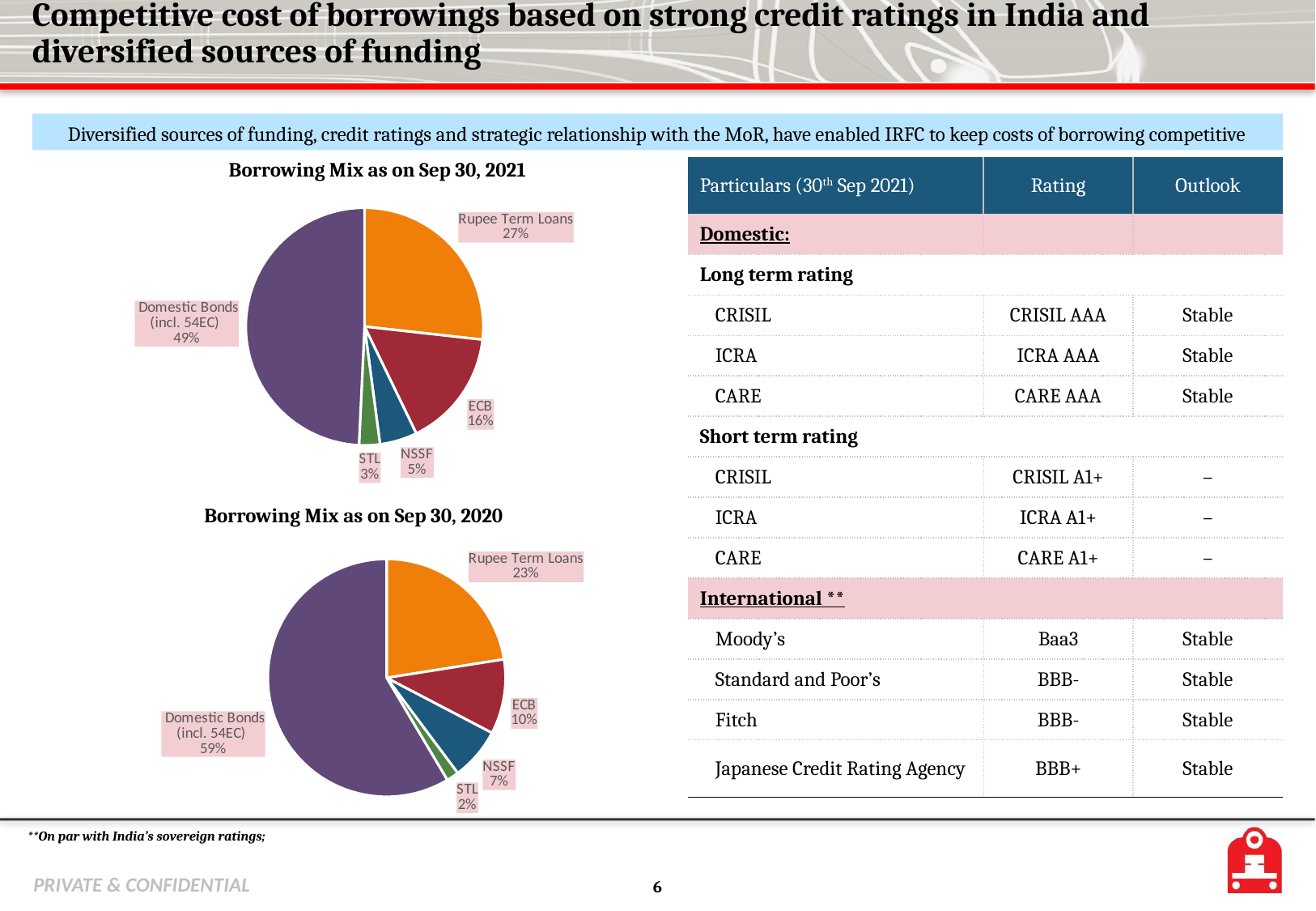
How many categories are shown in the 'Borrowing Mix as on Sep 30, 2021' chart? 5 In the 'Borrowing Mix as on Sep 30, 2020' chart, which category has the smallest share? STL In the 'Borrowing Mix as on Sep 30, 2020' chart, what is the share of Rupee Term Loans? 23% In the 'Borrowing Mix as on Sep 30, 2021' chart, what is the share of ECB? 16% What is the difference between the Domestic Bonds (incl. 54EC) share in the Sep 30, 2020 chart and in the Sep 30, 2021 chart? 10 percentage points What kind of chart is 'Borrowing Mix as on Sep 30, 2020'? Pie chart In the 'Borrowing Mix as on Sep 30, 2021' chart, which category has the largest share? Domestic Bonds (incl. 54EC) In the 'Borrowing Mix as on Sep 30, 2021' chart, what is the combined share of STL and NSSF? 8% In the 'Borrowing Mix as on Sep 30, 2020' chart, what is the share of NSSF? 7% What is the title of the top pie chart on the slide? Borrowing Mix as on Sep 30, 2021 In the 'Borrowing Mix as on Sep 30, 2021' chart, which is larger: the share of Rupee Term Loans or the share of ECB? Rupee Term Loans In the 'Borrowing Mix as on Sep 30, 2021' chart, what share do Domestic Bonds (incl. 54EC) have? 49%